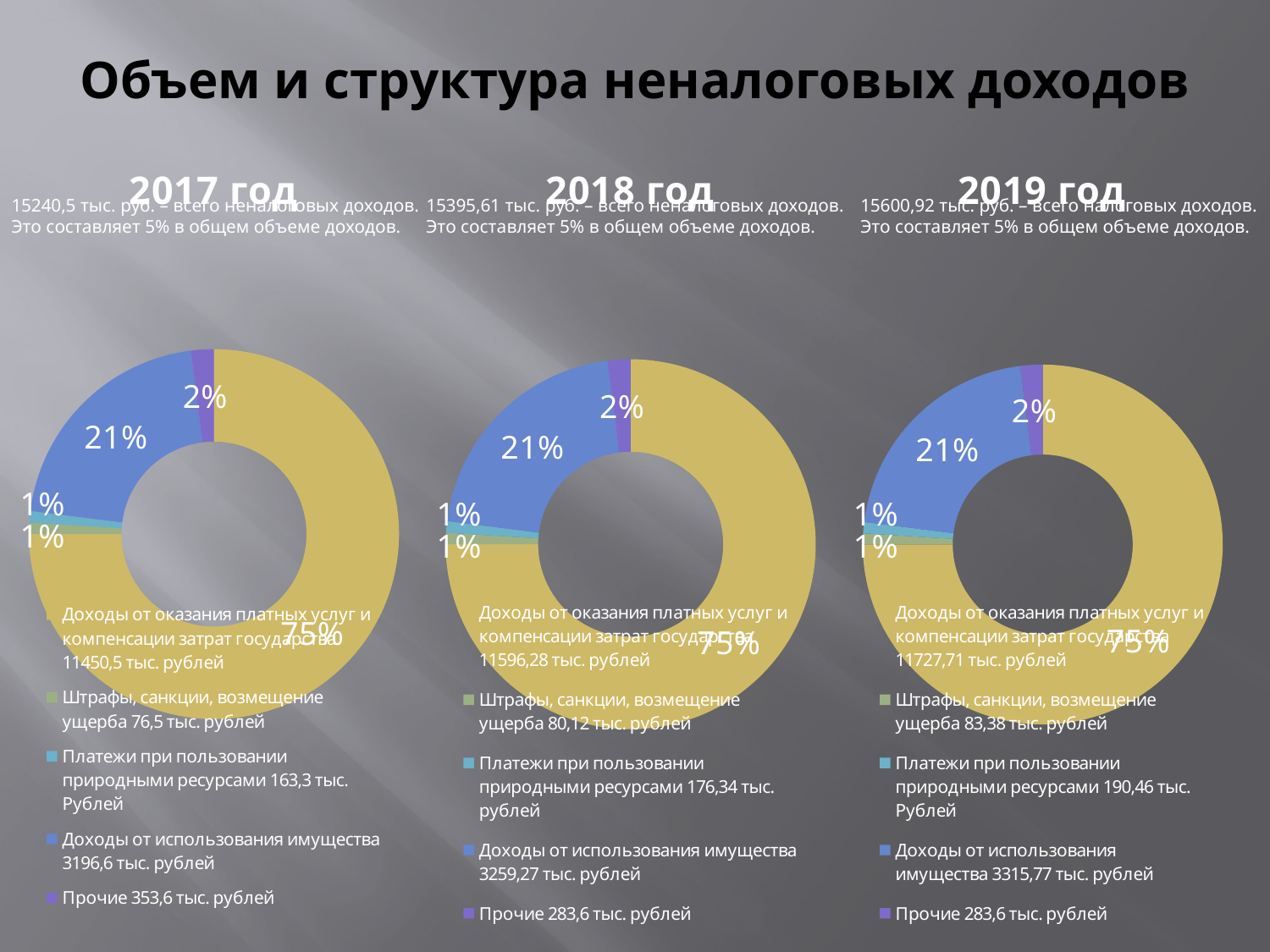
What kind of chart is used for the 2017 год chart? Doughnut (pie) chart According to the legend of the 2019 год chart, what is the value for Платежи при пользовании природными ресурсами? 190,46 тыс. рублей In the 2017 год chart, what share is shown for Прочие? 2% What is the title of the slide containing the three charts? Объем и структура неналоговых доходов According to the legend of the 2017 год chart, what is the value for Доходы от использования имущества? 3196,6 тыс. рублей How many entries does the legend of the 2019 год chart list? 5 According to the legend of the 2018 год chart, what is the value for Штрафы, санкции, возмещение ущерба? 80,12 тыс. рублей How many slices does the 2018 год chart have? 5 In the 2018 год chart, which slice is larger: Доходы от использования имущества or Прочие? Доходы от использования имущества In the 2018 год chart, which category has the largest slice? Доходы от оказания платных услуг и компенсации затрат государства In the 2017 год chart, what share is labelled for the largest slice? 75% In the 2019 год chart, what share is shown for Доходы от использования имущества? 21%